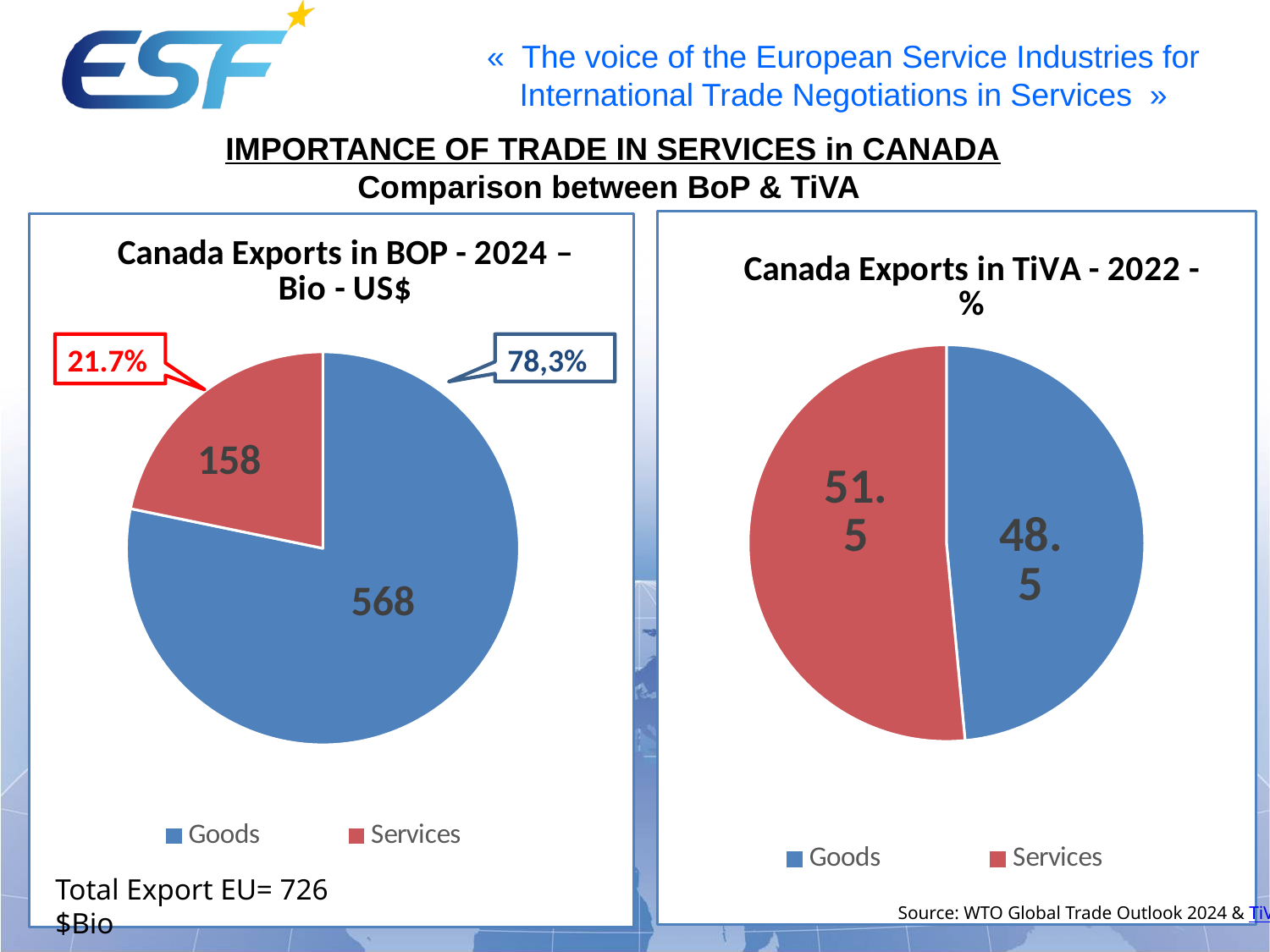
In the 'Canada Exports in BOP - 2024' chart, what is the difference between the Goods and Services values? 410 In the 'Canada Exports in TiVA - 2022' chart, which category has the smallest slice? Goods In the 'Canada Exports in TiVA - 2022' chart, what is the value for Services? 51.5 In the 'Canada Exports in TiVA - 2022' chart, is the value for Services larger or smaller than the value for Goods? larger In the 'Canada Exports in BOP - 2024' chart, which category has the largest slice? Goods In the 'Canada Exports in BOP - 2024' chart, what is the value for Services? 158 What type of chart is the 'Canada Exports in BOP - 2024' chart? pie chart In the 'Canada Exports in BOP - 2024' chart, what colour is the Goods slice? blue In the 'Canada Exports in BOP - 2024' chart, what share of the pie does the Services slice represent according to the callout label? 21.7% In the 'Canada Exports in BOP - 2024' chart, what is the value for Goods? 568 How many series does the legend of the 'Canada Exports in TiVA - 2022' chart list? 2 In the 'Canada Exports in TiVA - 2022' chart, what is the value for Goods? 48.5